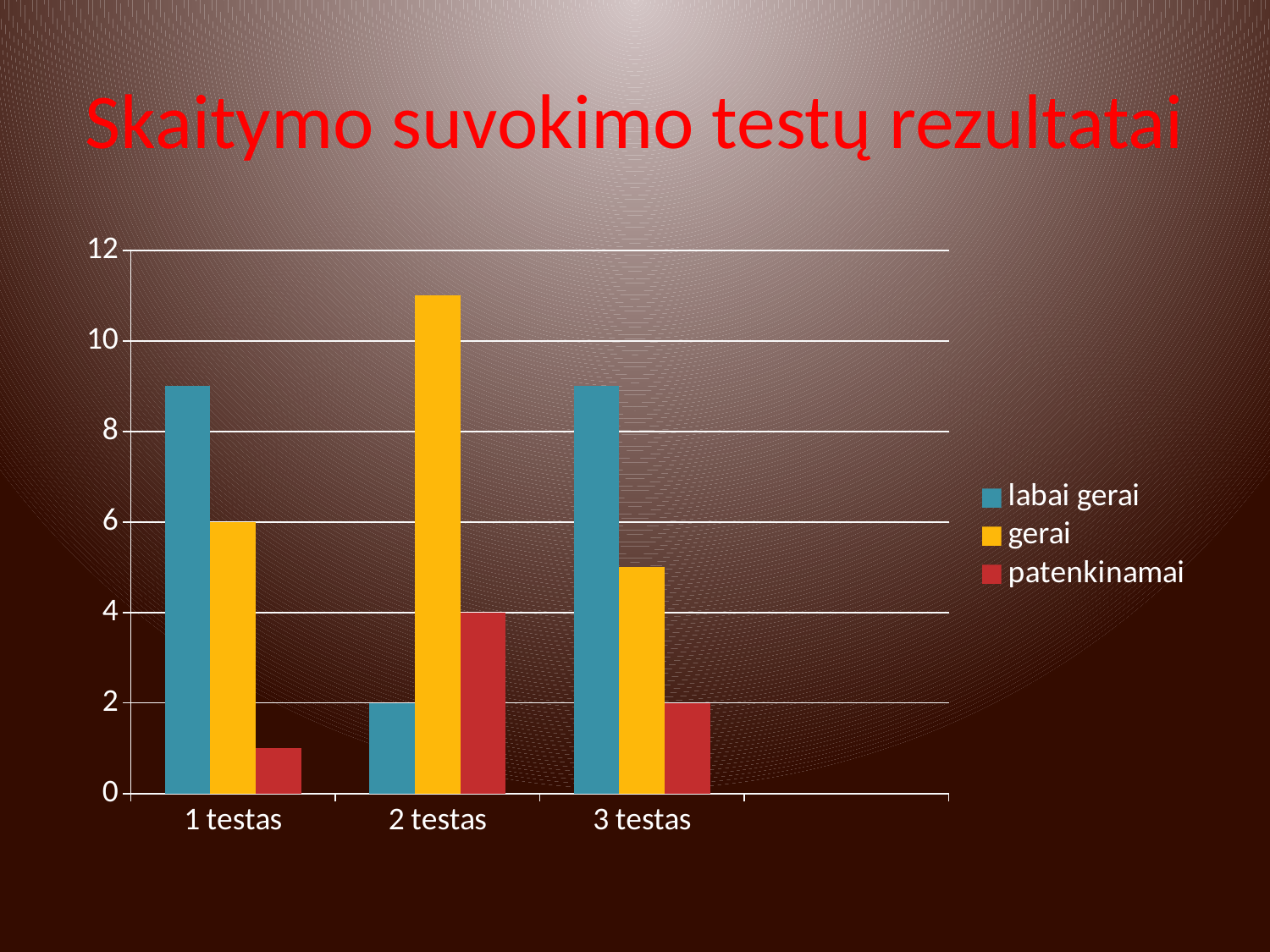
What is the value for labai gerai in 2 testas? 2 What is the value for patenkinamai in 3 testas? 2 What is the value for gerai in 1 testas? 6 What is the value for patenkinamai in 2 testas? 4 How many categories are shown on the x axis? 3 Which is larger in 3 testas: labai gerai or gerai? labai gerai Is the value for labai gerai in 1 testas greater or less than 8? greater Which category has the lowest value for patenkinamai? 1 testas Is the value for gerai in 2 testas greater or less than 10? greater How many series does the legend list? 3 Which category has the highest value for gerai? 2 testas What kind of chart is shown on the slide? bar chart